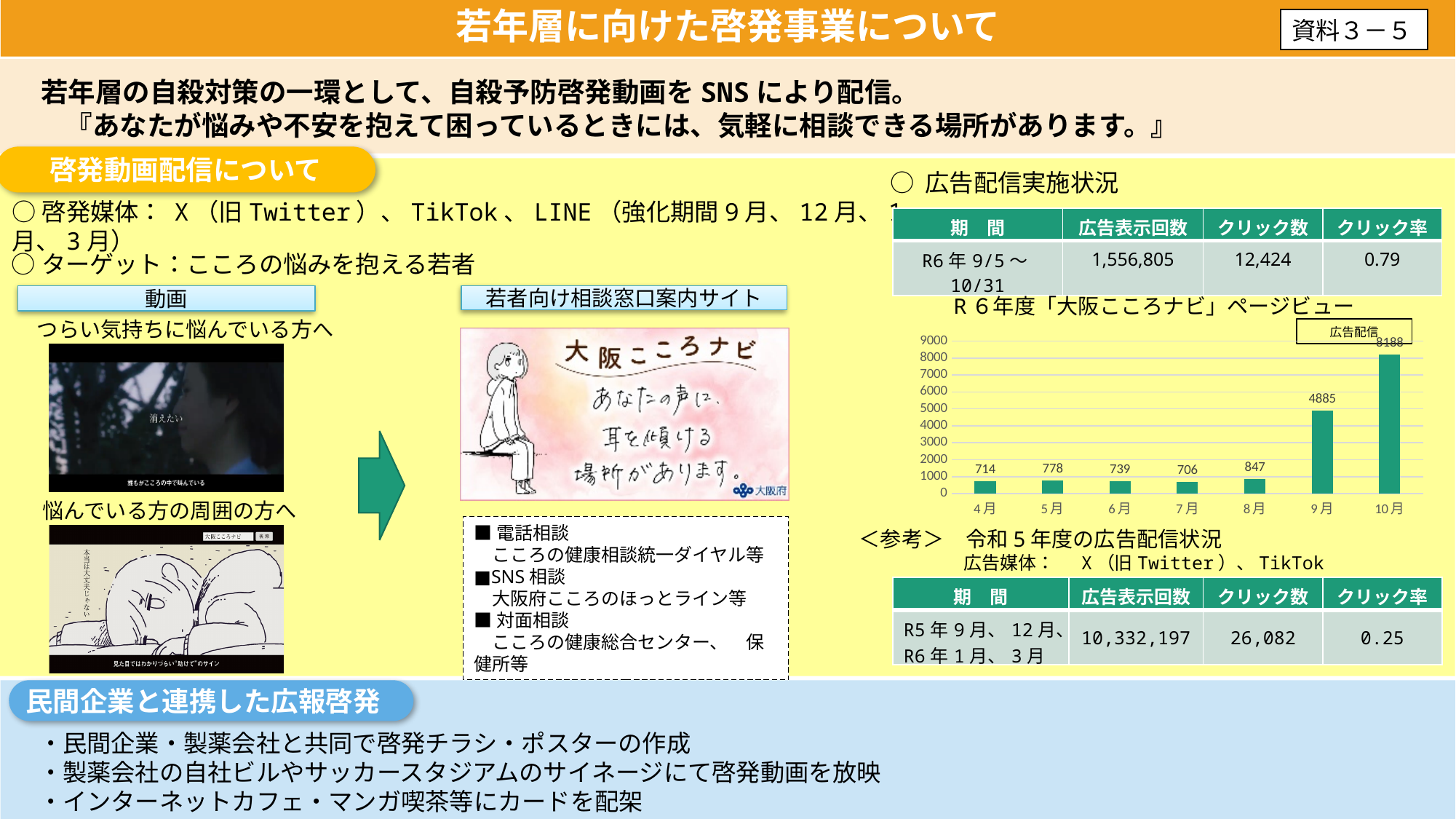
What is the title of the bar chart on the slide? R６年度「大阪こころナビ」ページビュー In the R6年度「大阪こころナビ」ページビュー chart, which is larger, the value for 5月 or 6月? 5月 What is the page view value for 4月 in the R6年度「大阪こころナビ」ページビュー chart? 714 In the R6年度「大阪こころナビ」ページビュー chart, what is the difference between the values for 9月 and 8月? 4038 Which month has the highest value in the R6年度「大阪こころナビ」ページビュー chart? 10月 How many months are shown on the x axis of the R6年度「大阪こころナビ」ページビュー chart? 7 What is the page view value for 8月 in the R6年度「大阪こころナビ」ページビュー chart? 847 Which month has the lowest value in the R6年度「大阪こころナビ」ページビュー chart? 7月 In the R6年度「大阪こころナビ」ページビュー chart, is the value for 10月 greater or less than 8000? greater What kind of chart is the R6年度「大阪こころナビ」ページビュー chart? bar chart What is the page view value for 9月 in the R6年度「大阪こころナビ」ページビュー chart? 4885 In the R6年度「大阪こころナビ」ページビュー chart, do the values rise or fall from 8月 to 10月? rise